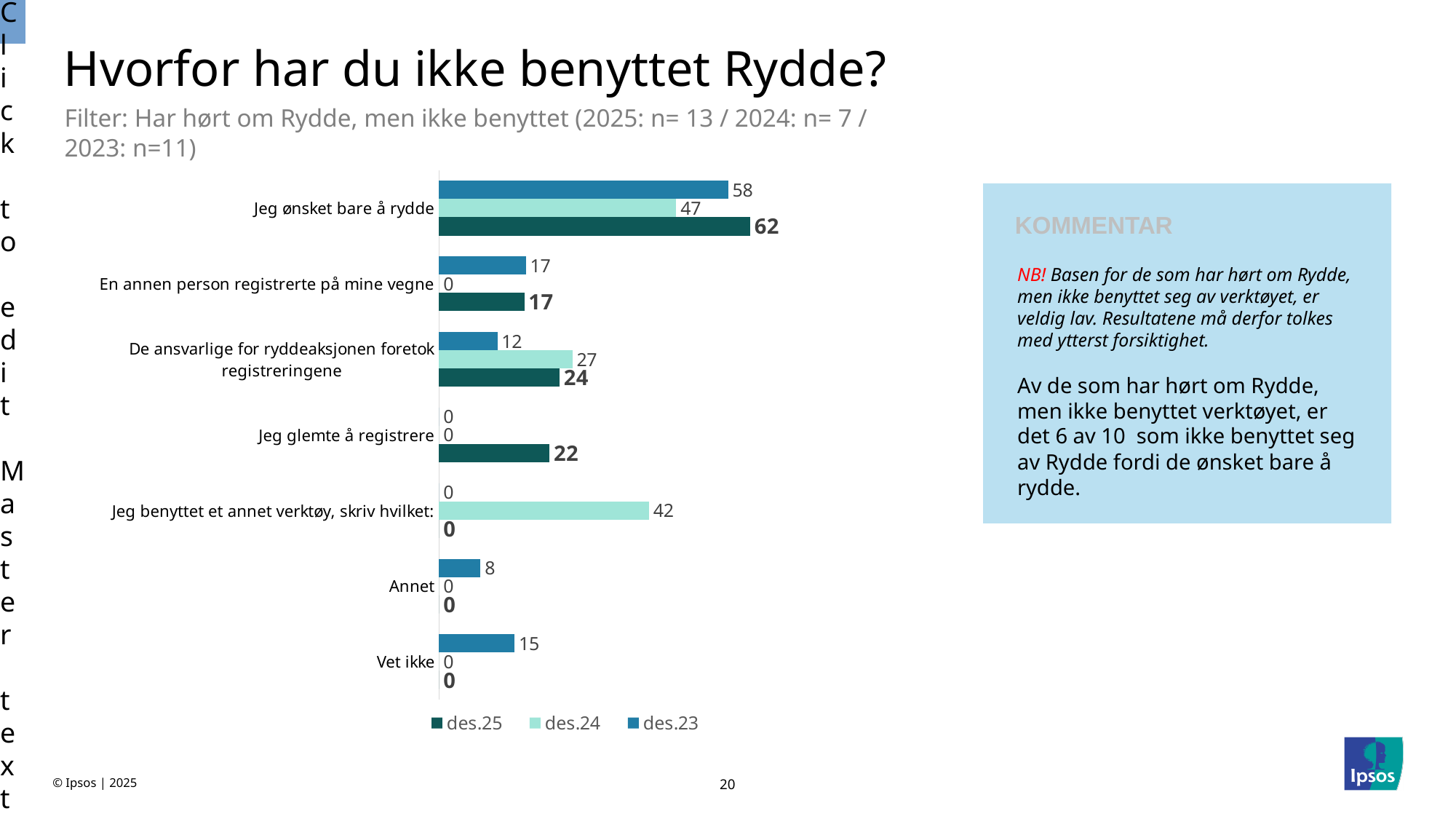
What is the des.23 value for "Annet"? 8 What is the difference between the des.25 and des.24 values for "Jeg ønsket bare å rydde"? 15 For "De ansvarlige for ryddeaksjonen foretok registreringene", which is larger: the des.24 value or the des.25 value? des.24 What is the des.24 value for "Jeg benyttet et annet verktøy, skriv hvilket:"? 42 What is the des.23 value for "Vet ikke"? 15 How many series does the legend list? 3 What kind of chart is shown on the slide? Bar chart What is the des.25 value for "Jeg glemte å registrere"? 22 How many categories are shown on the chart? 7 What is the des.25 value for "Jeg ønsket bare å rydde"? 62 Which category has the highest des.23 value? Jeg ønsket bare å rydde Which series is shown in the darkest colour in the legend? des.25